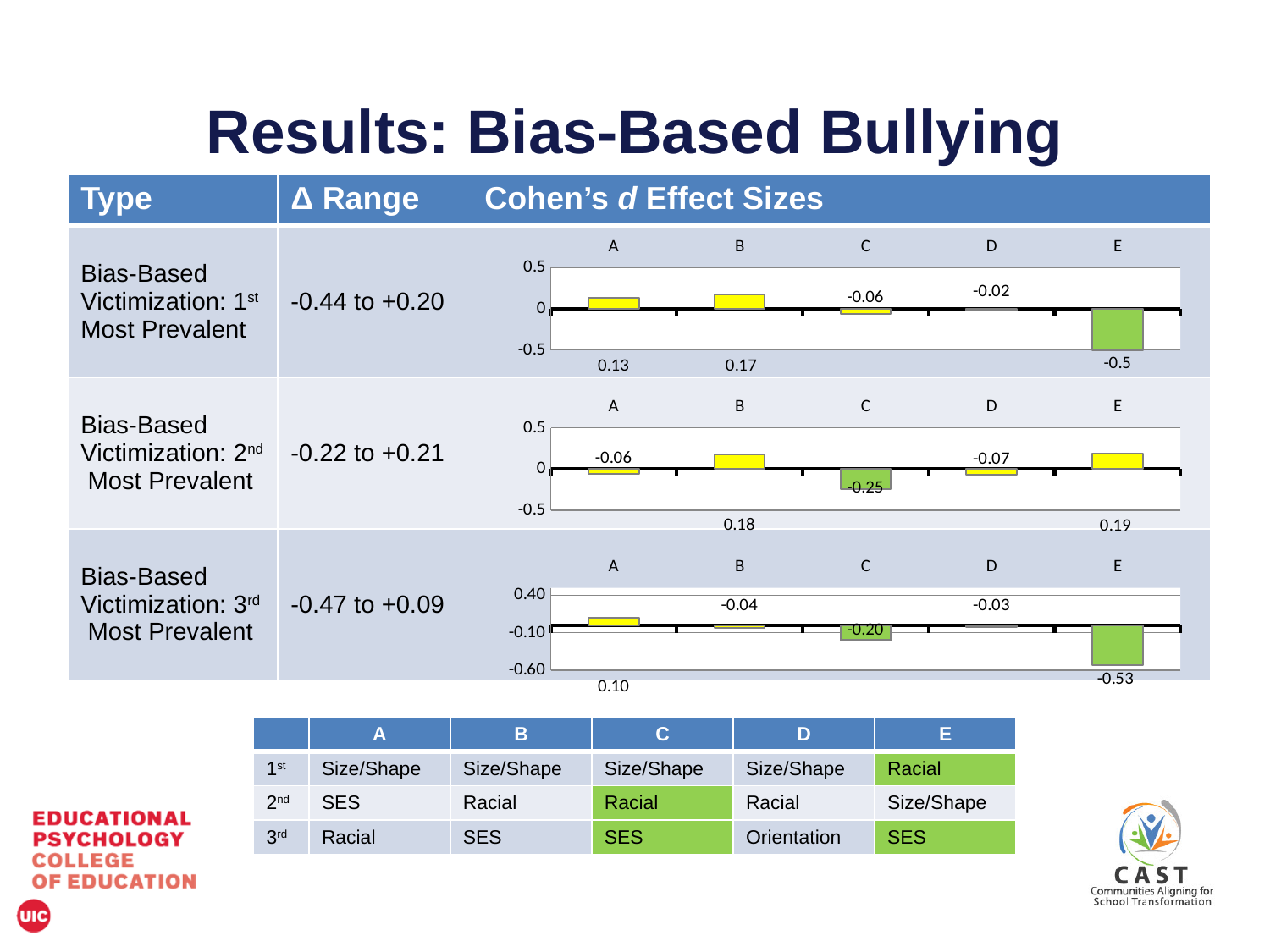
In the chart for Bias-Based Victimization: 3rd Most Prevalent, what is the value for E? -0.53 In the chart for Bias-Based Victimization: 1st Most Prevalent, what is the value for B? 0.17 How many categories are shown in the chart for Bias-Based Victimization: 1st Most Prevalent? 5 In the chart for Bias-Based Victimization: 1st Most Prevalent, what is the value for E? -0.5 What kind of chart is used for Bias-Based Victimization: 2nd Most Prevalent? Bar chart In the chart for Bias-Based Victimization: 1st Most Prevalent, which category has the highest value? B In the chart for Bias-Based Victimization: 2nd Most Prevalent, what is the value for C? -0.25 In the chart for Bias-Based Victimization: 2nd Most Prevalent, which category has the lowest value? C In the chart for Bias-Based Victimization: 2nd Most Prevalent, what is the value for D? -0.07 In the chart for Bias-Based Victimization: 3rd Most Prevalent, what is the value for A? 0.10 In the chart for Bias-Based Victimization: 3rd Most Prevalent, what is the difference between the values for A and E? 0.63 In the chart for Bias-Based Victimization: 1st Most Prevalent, which category has the lowest value? E